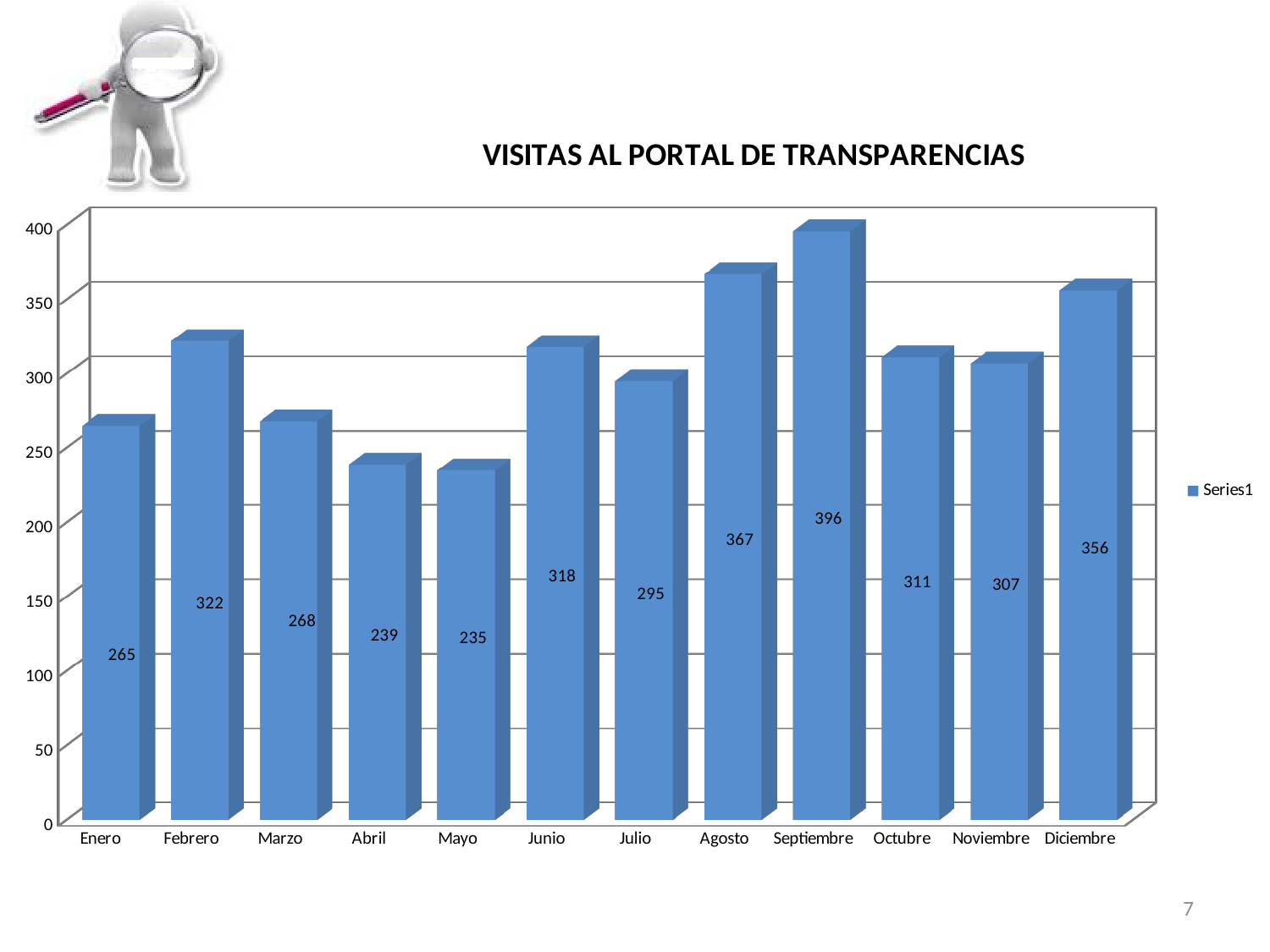
How many months are shown on the x axis? 12 What is the value for Septiembre? 396 What is the difference between the values for Septiembre and Mayo? 161 What is the title of the chart? VISITAS AL PORTAL DE TRANSPARENCIAS What kind of chart is shown? bar chart What is the difference between the values for Febrero and Enero? 57 Which month has the highest value? Septiembre What is the value for Mayo? 235 Is the value for Julio greater or less than 300? less Which month has the lowest value? Mayo What is the value for Enero? 265 Which is larger, the value for Agosto or the value for Diciembre? Agosto